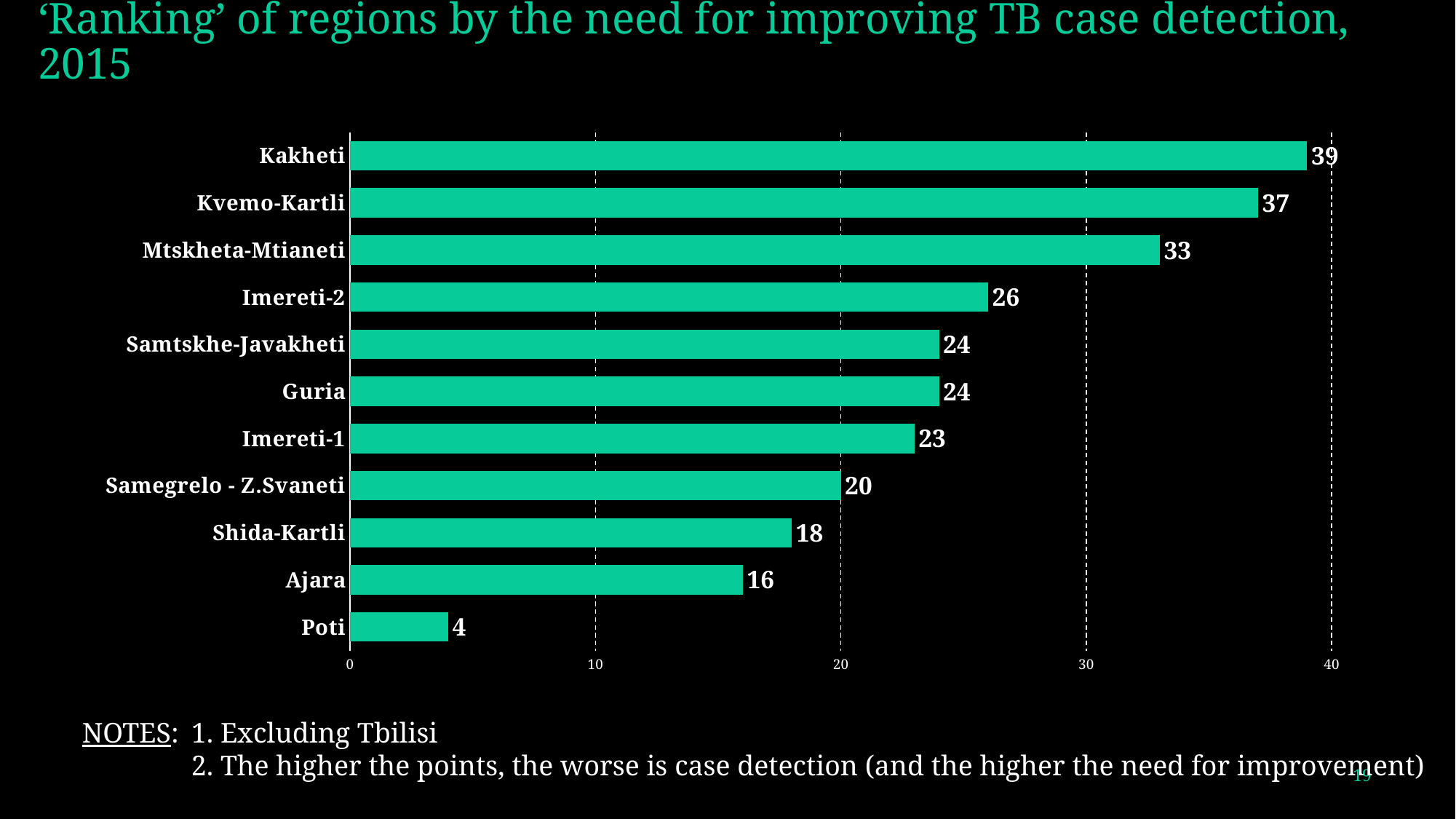
What is the value for Shida-Kartli? 18 What is the difference between the values for Kvemo-Kartli and Imereti-2? 11 Which region has the lowest value? Poti Is the value for Imereti-1 greater or less than 20? greater What kind of chart is shown on the slide? Bar chart What is the value for Mtskheta-Mtianeti? 33 Which region has the highest value? Kakheti What is the difference between the values for Kakheti and Poti? 35 What year does the chart title refer to? 2015 How many regions are shown in the chart? 11 What is the value for Kakheti? 39 Which has a larger value, Samegrelo - Z.Svaneti or Ajara? Samegrelo - Z.Svaneti